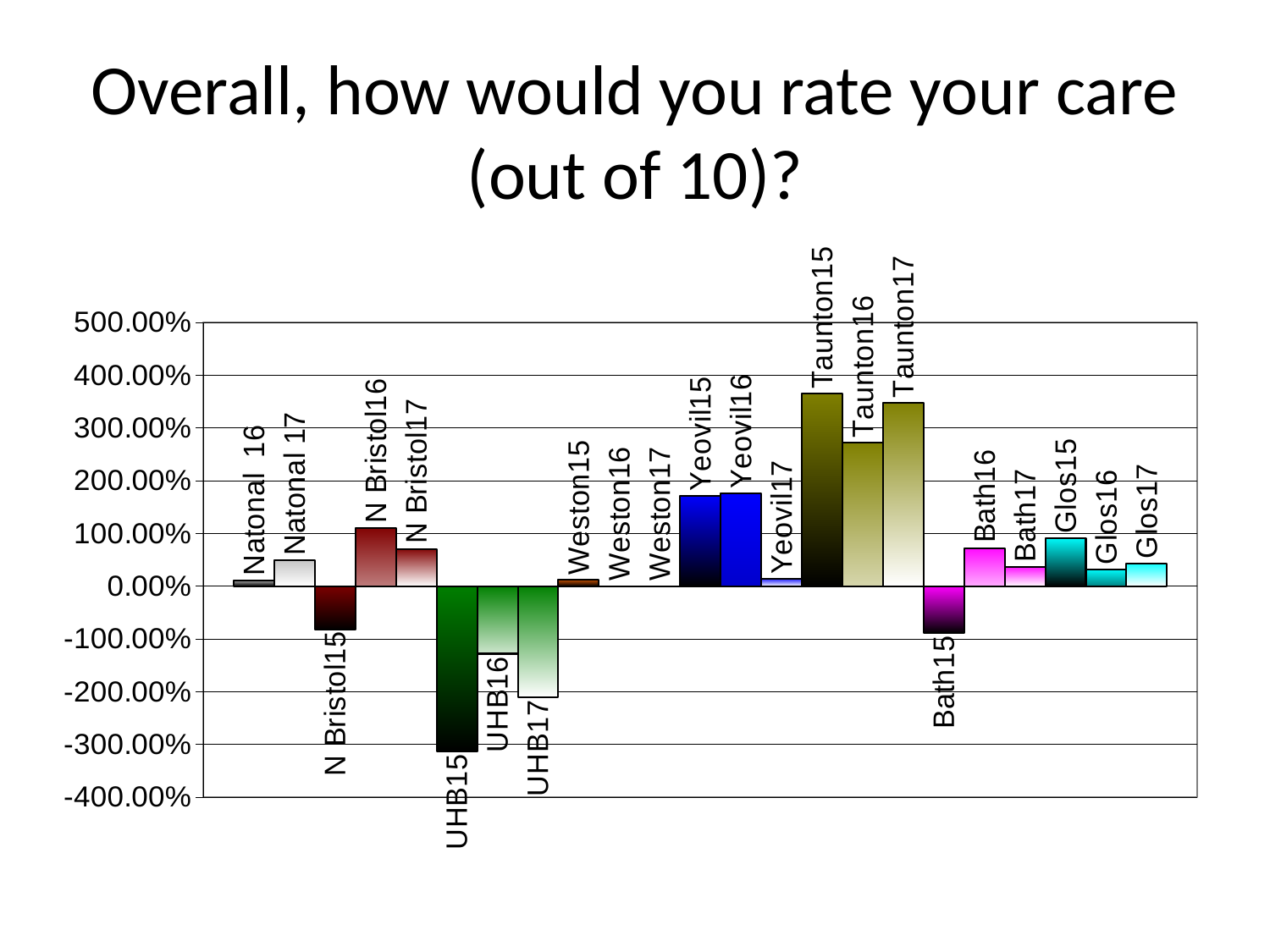
Is the value for Taunton15 greater or less than 300.00%? greater Is the value for UHB17 greater or less than -200.00%? less How many categories (bars) are plotted in the chart? 23 Which category has the highest value in the chart? Taunton15 What is the title of the slide's chart? Overall, how would you rate your care (out of 10)? Is the value for Taunton16 greater or less than 200.00%? greater What kind of chart is shown on the slide? bar chart Which category has the lowest value in the chart? UHB15 Which is larger, the value for Yeovil15 or the value for Yeovil17? Yeovil15 Which is larger, the value for Taunton15 or the value for Taunton16? Taunton15